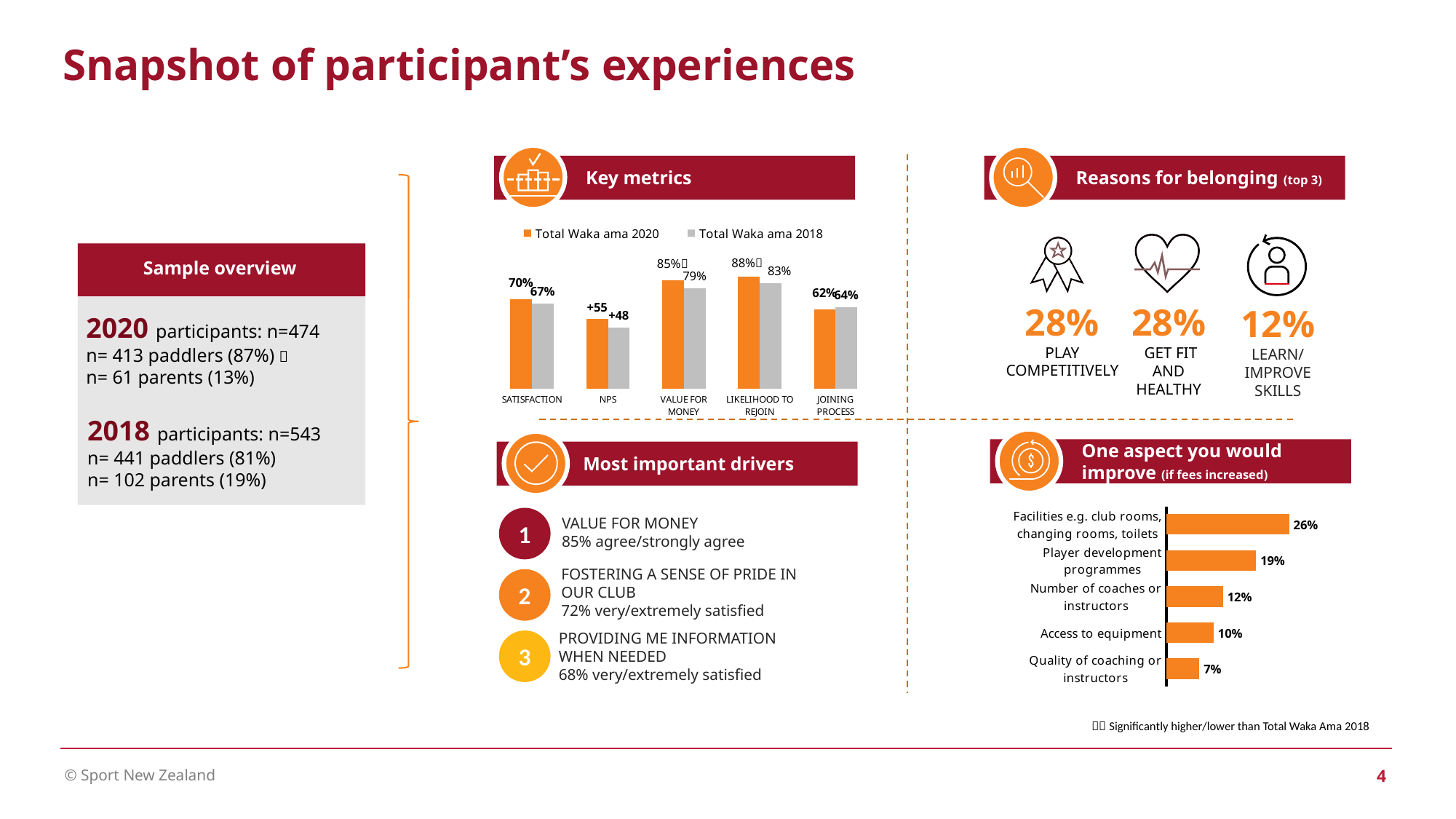
In the One aspect you would improve chart, what is the value for Player development programmes? 19% In the Key metrics chart, which metric has the highest value for Total Waka ama 2020? Likelihood to rejoin In the One aspect you would improve chart, which aspect has the lowest value? Quality of coaching or instructors In the One aspect you would improve chart, what is the difference between Facilities e.g. club rooms, changing rooms, toilets and Access to equipment? 16% In the Key metrics chart, what is the Satisfaction value for Total Waka ama 2020? 70% What type of chart is the One aspect you would improve chart? Bar chart In the Key metrics chart, what is the Likelihood to rejoin value for Total Waka ama 2020? 88% In the Key metrics chart, which is larger for Joining process: the 2020 value or the 2018 value? 2018 value In the Key metrics chart, what is the NPS value for Total Waka ama 2018? +48 In the Key metrics chart, what is the difference between the 2020 and 2018 values for Value for money? 6% How many series does the legend of the Key metrics chart list? 2 How many metrics are shown on the x axis of the Key metrics chart? 5